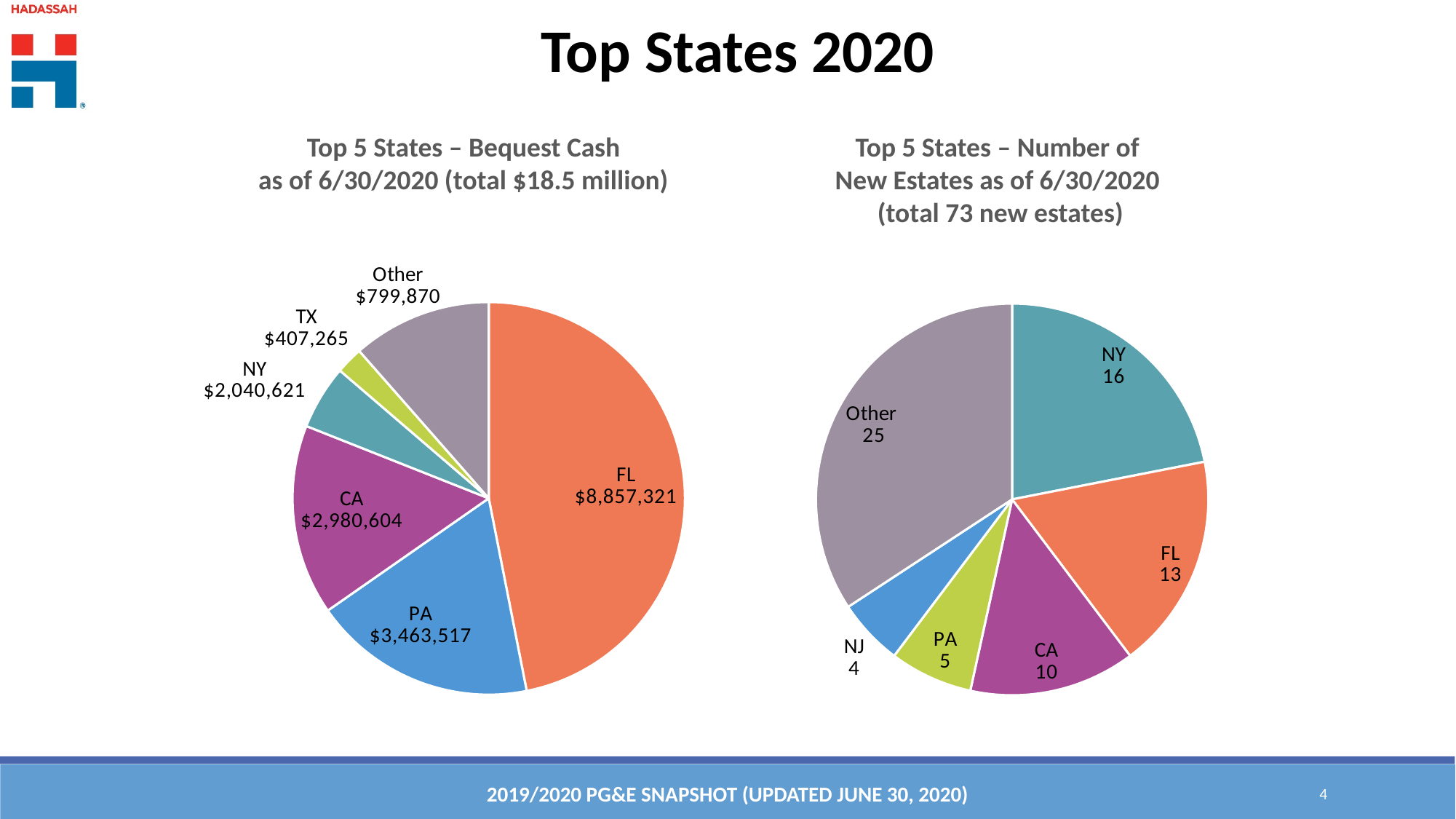
In the Bequest Cash pie chart, what is the value for NY? $2,040,621 In the Number of New Estates pie chart, how many new estates does CA have? 10 In the Bequest Cash pie chart, which state has the smallest slice? TX In the Bequest Cash pie chart, what is the difference between FL and PA? $5,393,804 What is the total number of new estates stated in the title of the right chart? 73 In the Bequest Cash pie chart, what is the value for FL? $8,857,321 How many slices does the Bequest Cash pie chart have? 6 In the Number of New Estates pie chart, which state has the most new estates? NY In the Bequest Cash pie chart, which is larger, CA or NY? CA In the Number of New Estates pie chart, which state has the fewest new estates? NJ In the Number of New Estates pie chart, what is the difference between NY and FL? 3 What type of chart is used on the right side of the slide? Pie chart